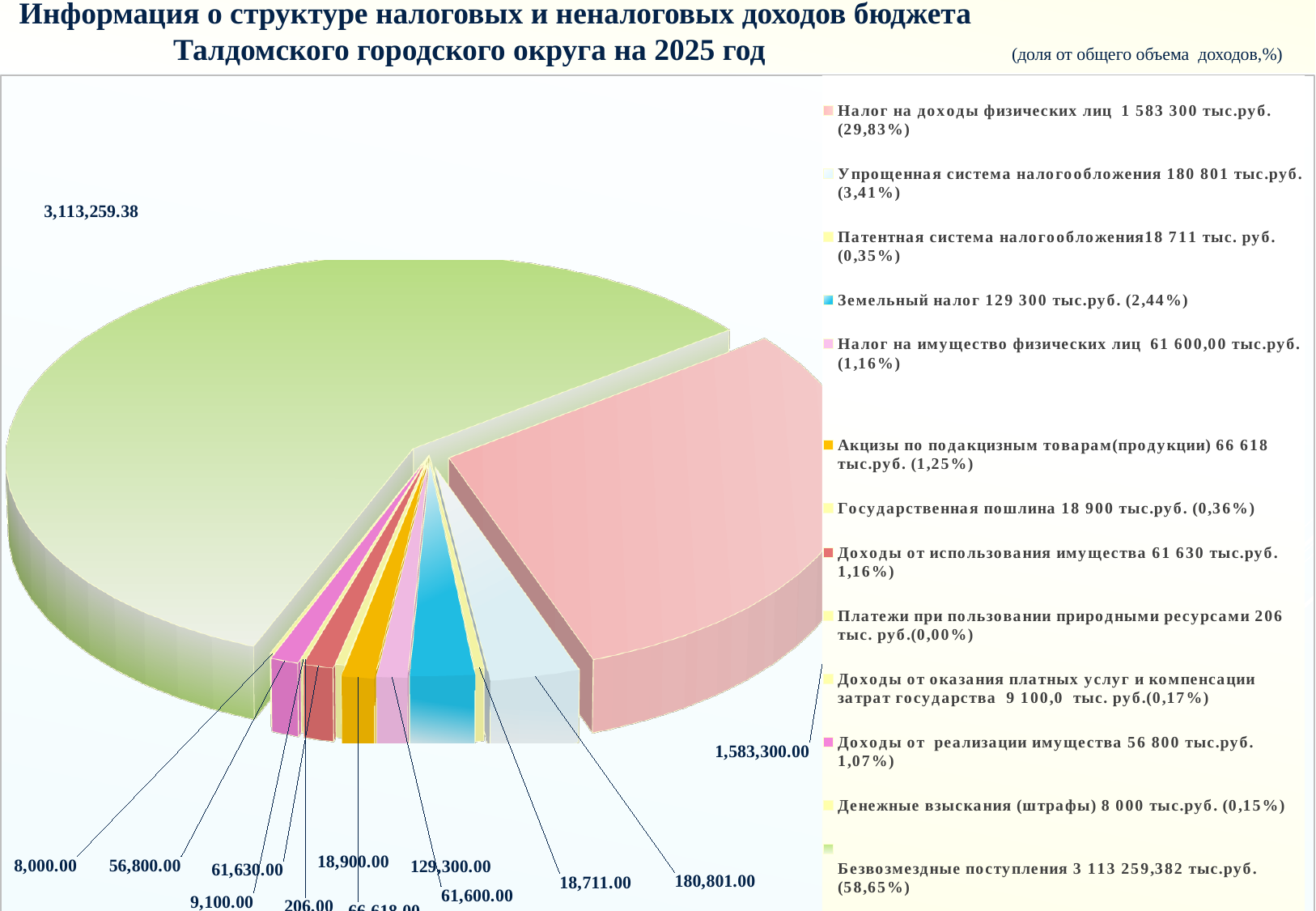
What is the data label value for Земельный налог? 129,300.00 What is the data label value for Налог на доходы физических лиц? 1,583,300.00 Which is larger: Земельный налог or Упрощенная система налогообложения? Упрощенная система налогообложения What share of total revenue does Безвозмездные поступления represent according to the legend? 58,65% Which category has the largest slice of the pie? Безвозмездные поступления Which category has the smallest slice of the pie? Платежи при пользовании природными ресурсами What is the difference between the values for Налог на доходы физических лиц and Упрощенная система налогообложения? 1,402,499.00 What is the data label value for Акцизы по подакцизным товарам (продукции)? 66,618.00 How many slices (categories) does the pie chart have? 13 What is the difference between the values for Земельный налог and Налог на имущество физических лиц? 67,700.00 What kind of chart is shown on the slide? Pie chart What share of total revenue does Упрощенная система налогообложения represent according to the legend? 3,41%